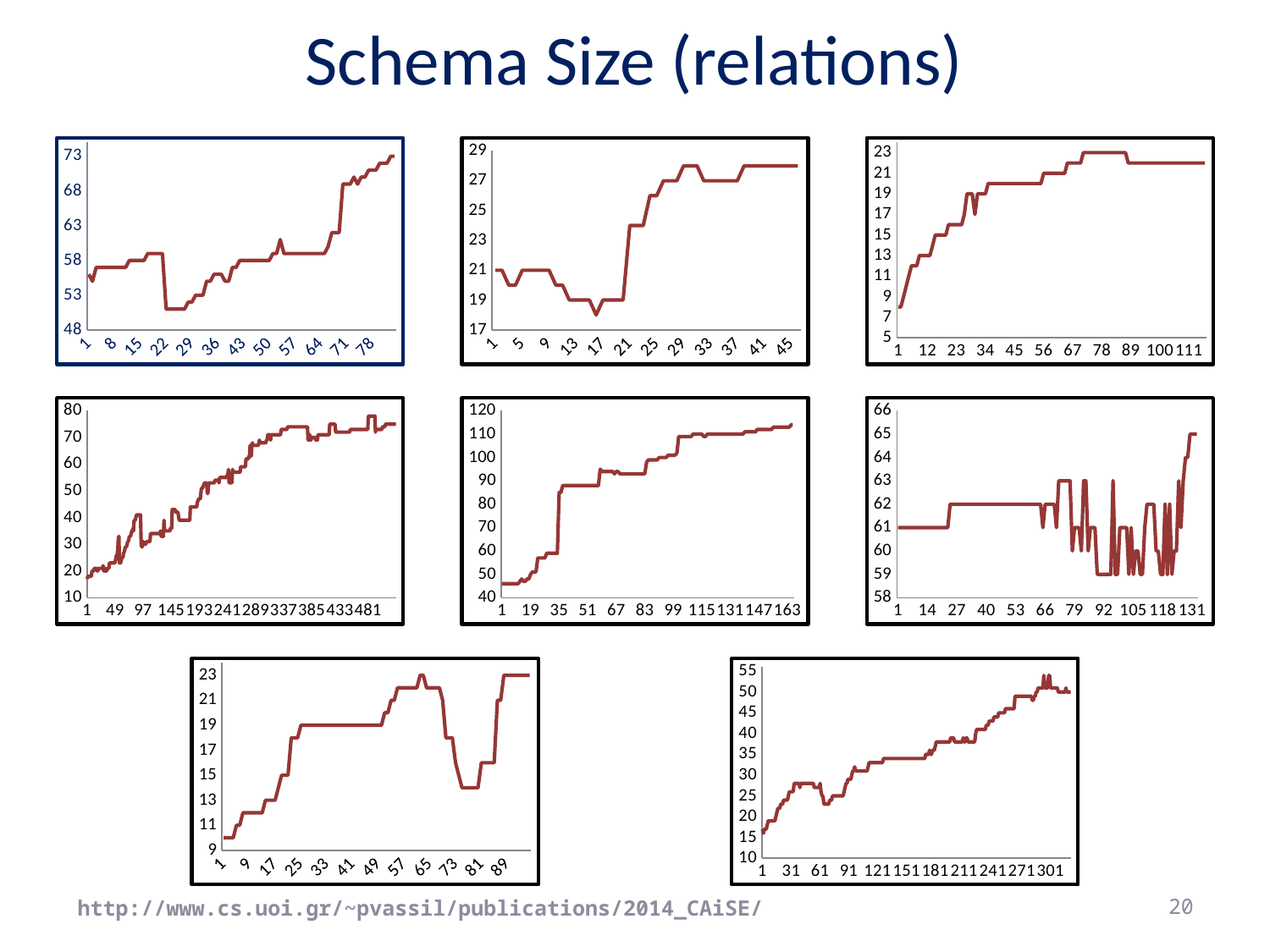
In the middle chart of the middle row, is the value at x = 163 greater or less than 110? greater In the top-right chart, do the values generally rise or fall along the x axis? rise In the bottom-right chart, do the values generally rise or fall along the x axis? rise In the middle-left chart, is the value at x = 1 greater or less than 20? less How many charts are shown on the slide? 8 In the top-middle chart, is the value at x = 45 greater or less than 27? greater What is the title of the slide containing these charts? Schema Size (relations) What kind of chart is the top-left chart on the slide? line chart